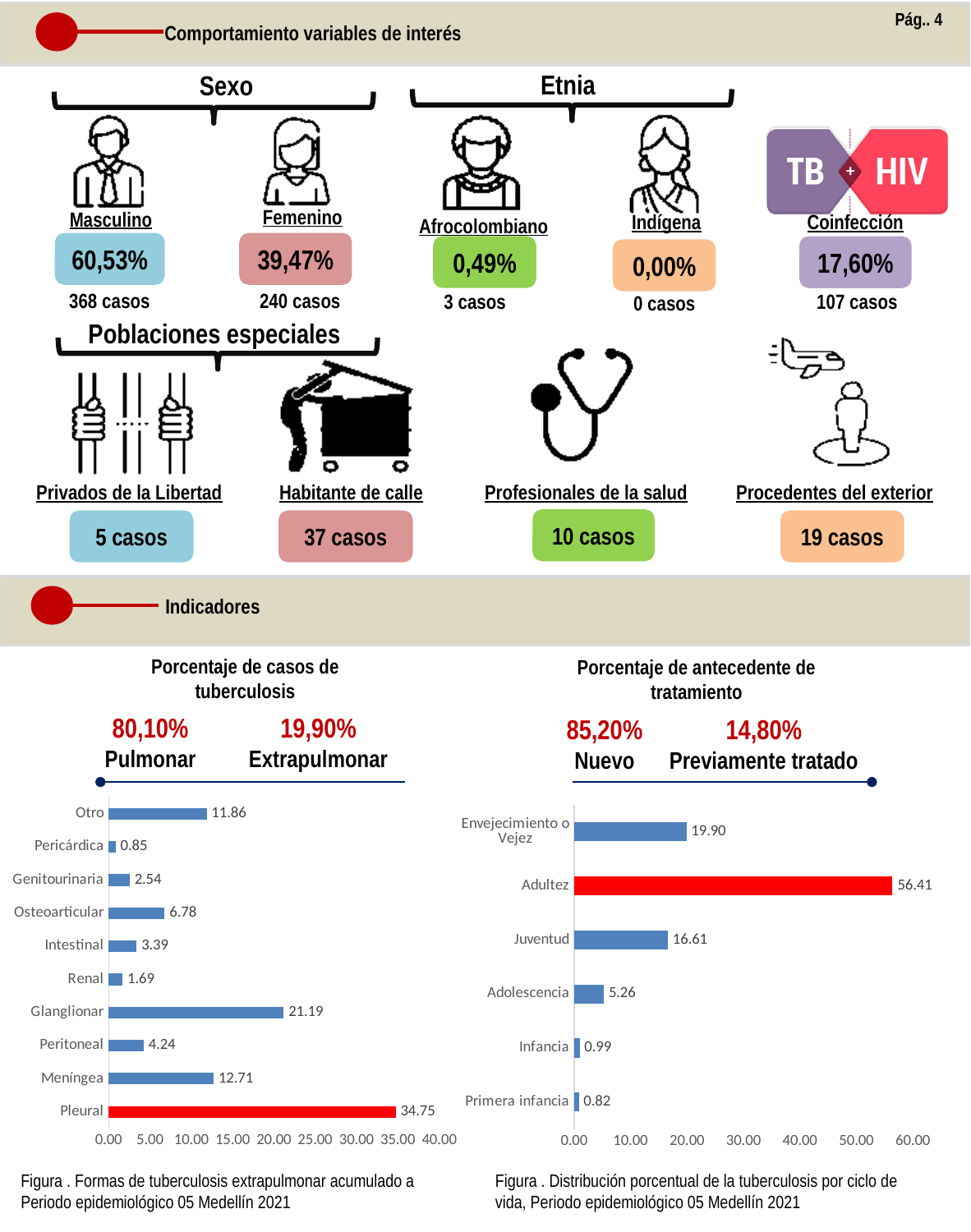
In the left chart (Formas de tuberculosis extrapulmonar), which is larger, Osteoarticular or Intestinal? Osteoarticular What kind of chart is the right chart (Distribución porcentual de la tuberculosis por ciclo de vida)? Bar chart In the left chart (Formas de tuberculosis extrapulmonar), what is the difference between Meníngea and Otro? 0.85 In the left chart (Formas de tuberculosis extrapulmonar), which category has the lowest value? Pericárdica In the right chart (Distribución porcentual de la tuberculosis por ciclo de vida), what is the value for Primera infancia? 0.82 In the left chart (Formas de tuberculosis extrapulmonar), what is the value for Pleural? 34.75 In the right chart (Distribución porcentual de la tuberculosis por ciclo de vida), which category has the highest value? Adultez In the right chart (Distribución porcentual de la tuberculosis por ciclo de vida), what is the value for Adultez? 56.41 In the right chart (Distribución porcentual de la tuberculosis por ciclo de vida), how many categories are plotted? 6 In the left chart (Formas de tuberculosis extrapulmonar), what is the value for Glanglionar? 21.19 In the right chart (Distribución porcentual de la tuberculosis por ciclo de vida), what is the difference between Envejecimiento o Vejez and Juventud? 3.29 In the left chart (Formas de tuberculosis extrapulmonar), how many categories are plotted? 10